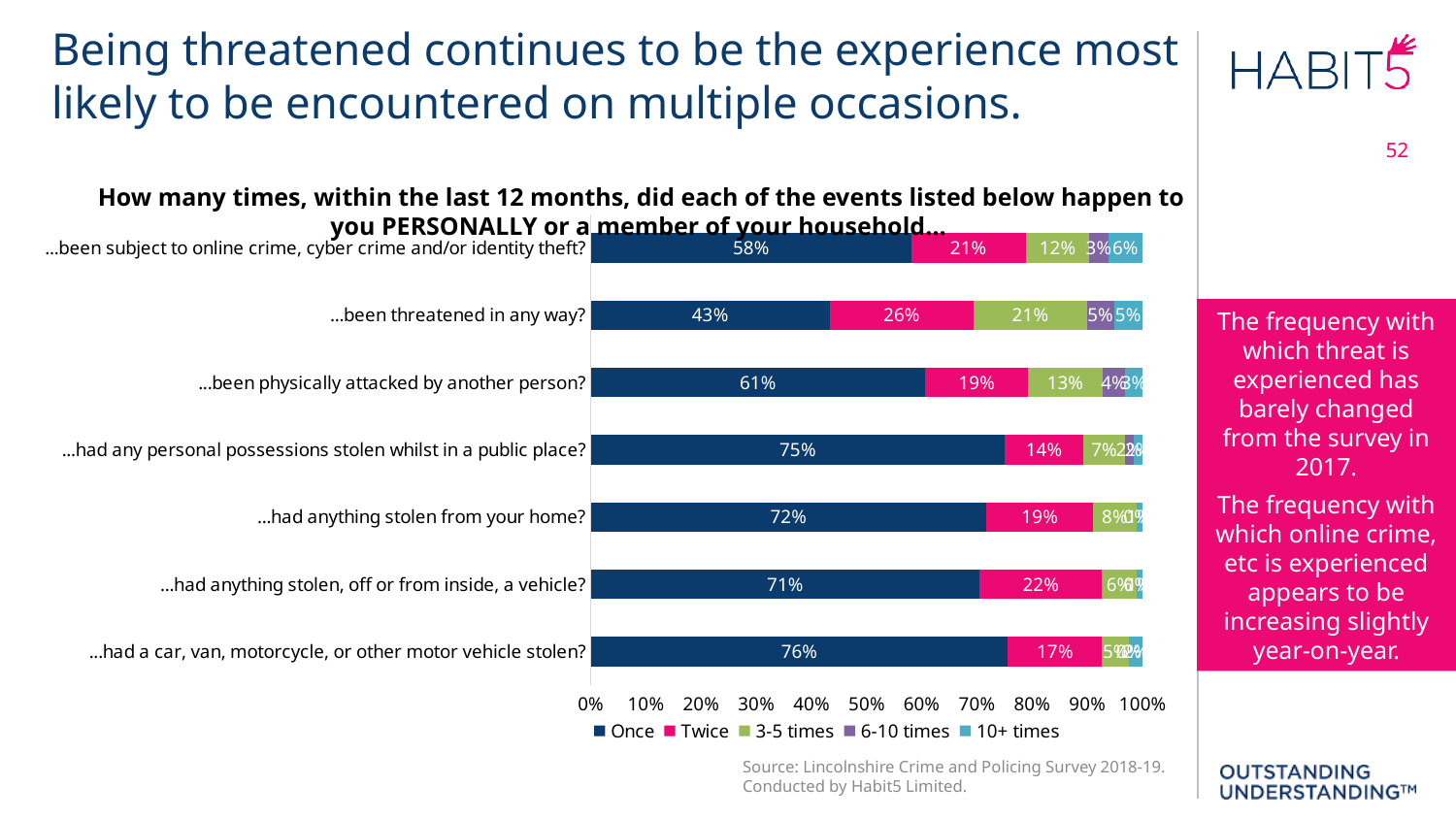
What kind of chart is shown on the slide? Stacked bar chart Which event has the lowest 'Once' value? ...been threatened in any way? How many event categories are listed on the chart? 7 What percentage of respondents said they had been threatened in any way once? 43% What is the 'Twice' value for '...been threatened in any way?' 26% How many series does the chart legend list? 5 Which event has the highest 'Once' value? ...had a car, van, motorcycle, or other motor vehicle stolen? Which series is shown in dark navy in the legend? Once What is the 'Once' value for '...had a car, van, motorcycle, or other motor vehicle stolen?' 76% What is the difference between the 'Once' value for motor vehicle stolen (76%) and the 'Once' value for been threatened in any way (43%)? 33 percentage points Which has a larger 'Twice' value: '...been threatened in any way?' or '...been physically attacked by another person?' ...been threatened in any way? What is the '3-5 times' value for '...been subject to online crime, cyber crime and/or identity theft?' 12%